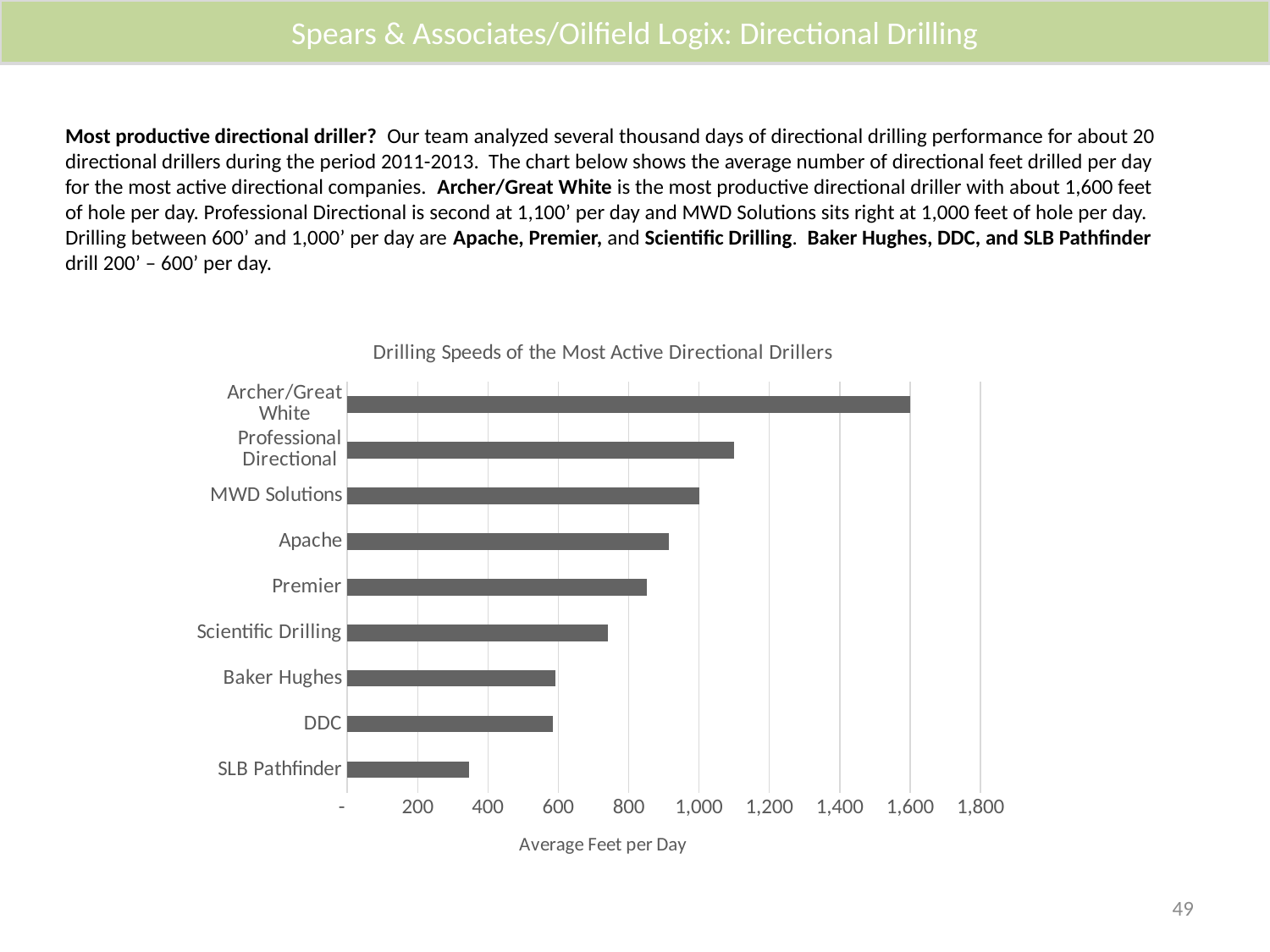
Do the bar values decrease or increase going from the top driller to the bottom driller? decrease How many directional drillers are plotted in the chart? 9 Is the value for Scientific Drilling greater or less than 800? less Is the value for SLB Pathfinder greater or less than 400? less Which has a higher average feet per day, Premier or Scientific Drilling? Premier Which driller has the highest average feet per day? Archer/Great White Is the value for Apache greater or less than 800? greater Which driller has the lowest average feet per day? SLB Pathfinder What kind of chart is shown on the slide? bar chart What is the title of the chart? Drilling Speeds of the Most Active Directional Drillers Which has a higher average feet per day, Apache or Premier? Apache